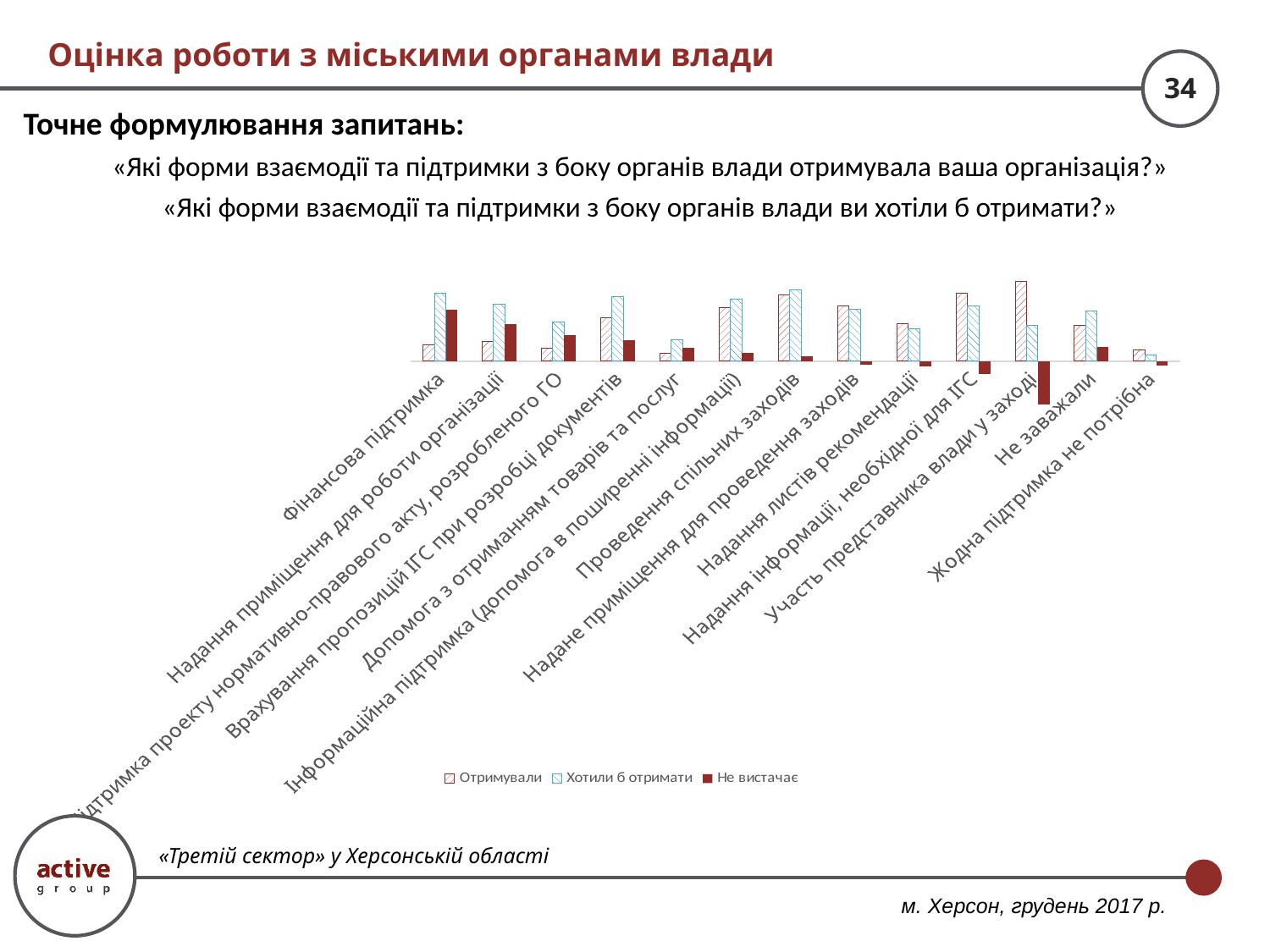
For the series "Не вистачає", which is larger: "Фінансова підтримка" or "Жодна підтримка не потрібна"? Фінансова підтримка How many series does the chart legend list? 3 For "Фінансова підтримка", which is larger: "Отримували" or "Хотили б отримати"? Хотили б отримати Which category has the lowest value for the series "Не вистачає"? Участь представника влади у заході What kind of chart is shown on the slide? bar chart How many categories are shown along the x axis of the chart? 13 Which category has the highest value for the series "Не вистачає"? Фінансова підтримка Which category has the highest value for the series "Отримували"? Участь представника влади у заході For "Не заважали", which is larger: "Хотили б отримати" or "Не вистачає"? Хотили б отримати Which series in the legend is shown as a solid dark red bar? Не вистачає What are the three series named in the chart legend? Отримували, Хотили б отримати, Не вистачає